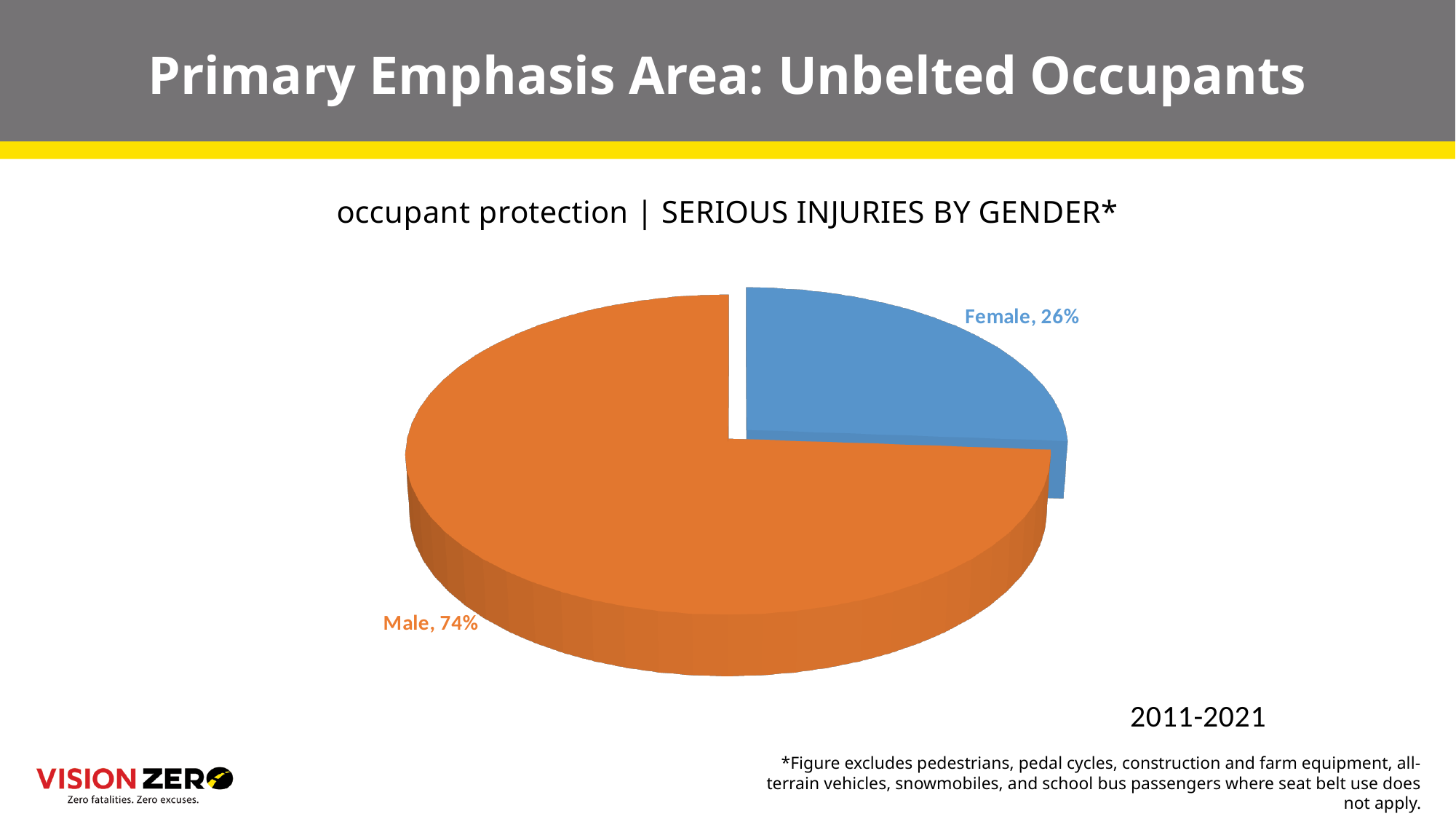
What share of serious injuries is attributed to males? 74% What kind of chart is shown on the slide? pie chart Which gender has the largest share of serious injuries? Male How many slices does the pie chart have? 2 What time period does the chart cover? 2011-2021 What is the difference in percentage points between the Male and Female shares? 48 What colour is the Female slice of the pie? blue What share of serious injuries is attributed to females? 26% Which is larger, the Male share or the Female share? Male What is the title of the chart? occupant protection | SERIOUS INJURIES BY GENDER* Which gender has the smallest share of serious injuries? Female